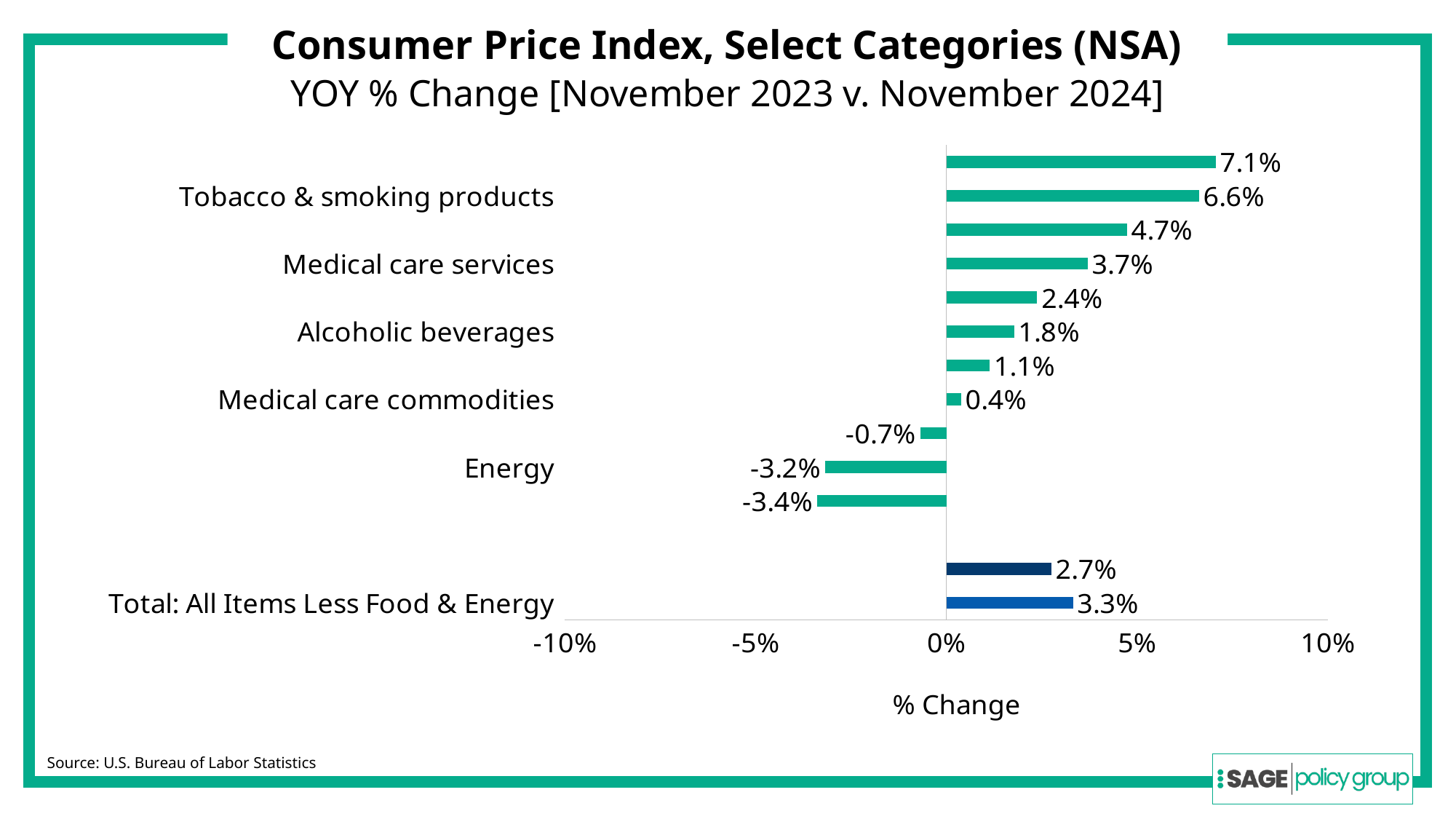
What is the highest value shown on the chart? 7.1% What is the YOY % change for Total: All Items Less Food & Energy? 3.3% What is the YOY % change for Medical care services? 3.7% What is the YOY % change for Energy? -3.2% Which is larger, the value for Alcoholic beverages or the value for Medical care commodities? Alcoholic beverages What is the YOY % change for Medical care commodities? 0.4% How many bars are plotted on the chart? 13 What is the difference between the values for Tobacco & smoking products and Medical care services? 2.9 percentage points What is the lowest value shown on the chart? -3.4% What kind of chart is shown on the slide? Bar chart What is the YOY % change for Tobacco & smoking products? 6.6% What is the YOY % change for Alcoholic beverages? 1.8%